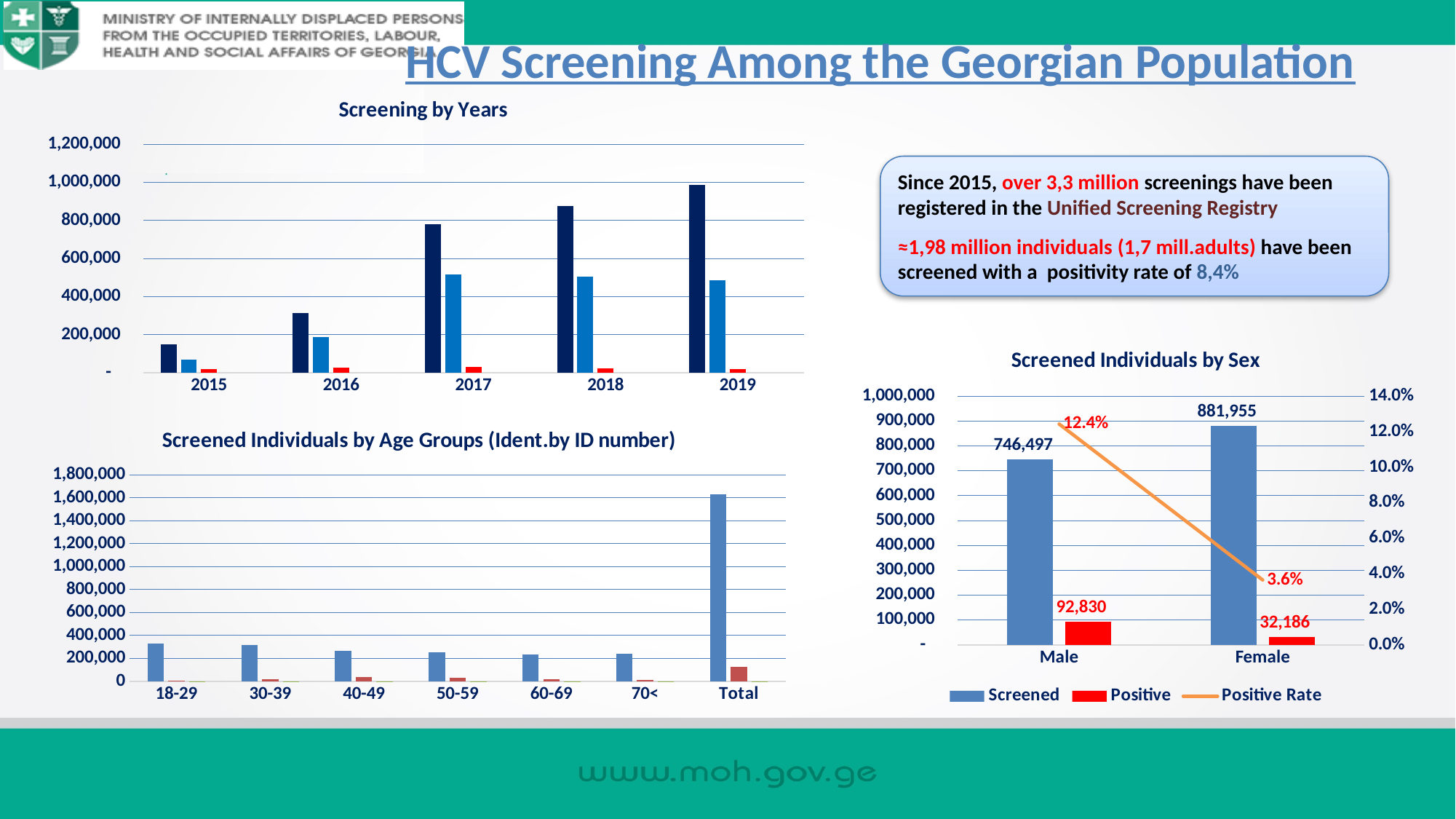
In the 'Screened Individuals by Sex' chart, what is the difference between the number of females screened and the number of males screened? 135,458 How many categories are shown on the x axis of the 'Screened Individuals by Age Groups' chart? 7 What kind of chart is 'Screening by Years'? bar chart In the 'Screening by Years' chart, do the dark blue bars rise or fall from 2015 to 2019? rise In the 'Screened Individuals by Sex' chart, how many individuals were screened among males? 746,497 In the 'Screened Individuals by Sex' chart, what is the number of positive cases for males? 92,830 In the 'Screened Individuals by Sex' chart, how many individuals were screened among females? 881,955 How many series does the legend of the 'Screened Individuals by Sex' chart list? 3 In the 'Screened Individuals by Sex' chart, what is the difference between the number of positive cases for males and for females? 60,644 In the 'Screened Individuals by Sex' chart, which sex has the higher positive rate? Male In the 'Screened Individuals by Age Groups' chart, is the screened value for Total greater or less than 1,400,000? greater In the 'Screened Individuals by Sex' chart, what is the positive rate for females? 3.6%